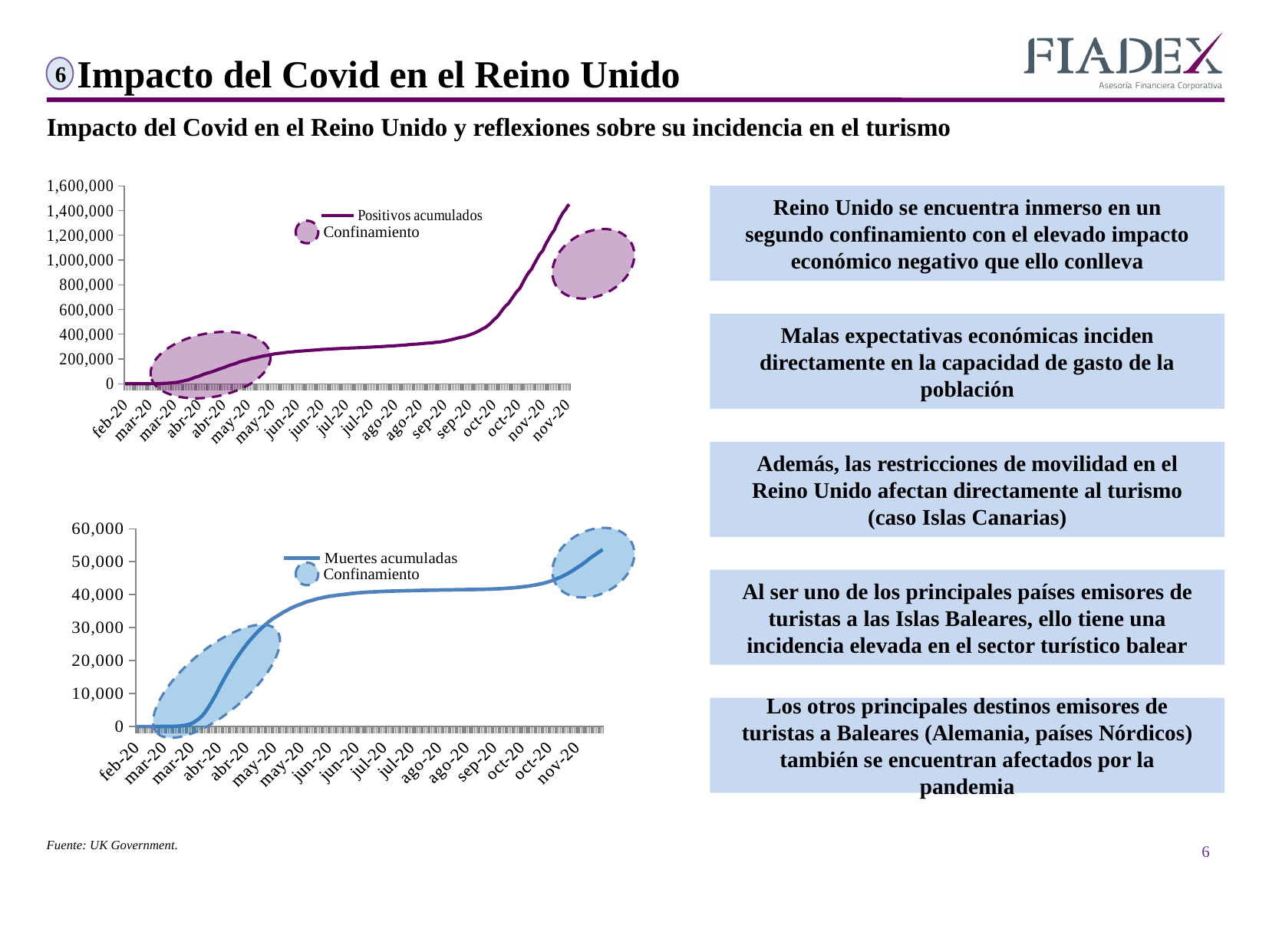
How many entries does the legend of the top chart list? 2 What is the name of the line series in the bottom chart? Muertes acumuladas What kind of chart is the top chart on the slide? line chart In the top chart, which month shows the highest value of Positivos acumulados? nov-20 In the bottom chart, is the value of Muertes acumuladas at jul-20 greater or less than 30,000? greater In the top chart, do the values of Positivos acumulados rise or fall from feb-20 to nov-20? rise In the bottom chart, do the values of Muertes acumuladas rise or fall from feb-20 to nov-20? rise In the bottom chart, which is larger: the value of Muertes acumuladas at mar-20 or at jul-20? jul-20 What kind of chart is the bottom chart on the slide? line chart In the top chart, is the value of Positivos acumulados at jun-20 greater or less than 400,000? less